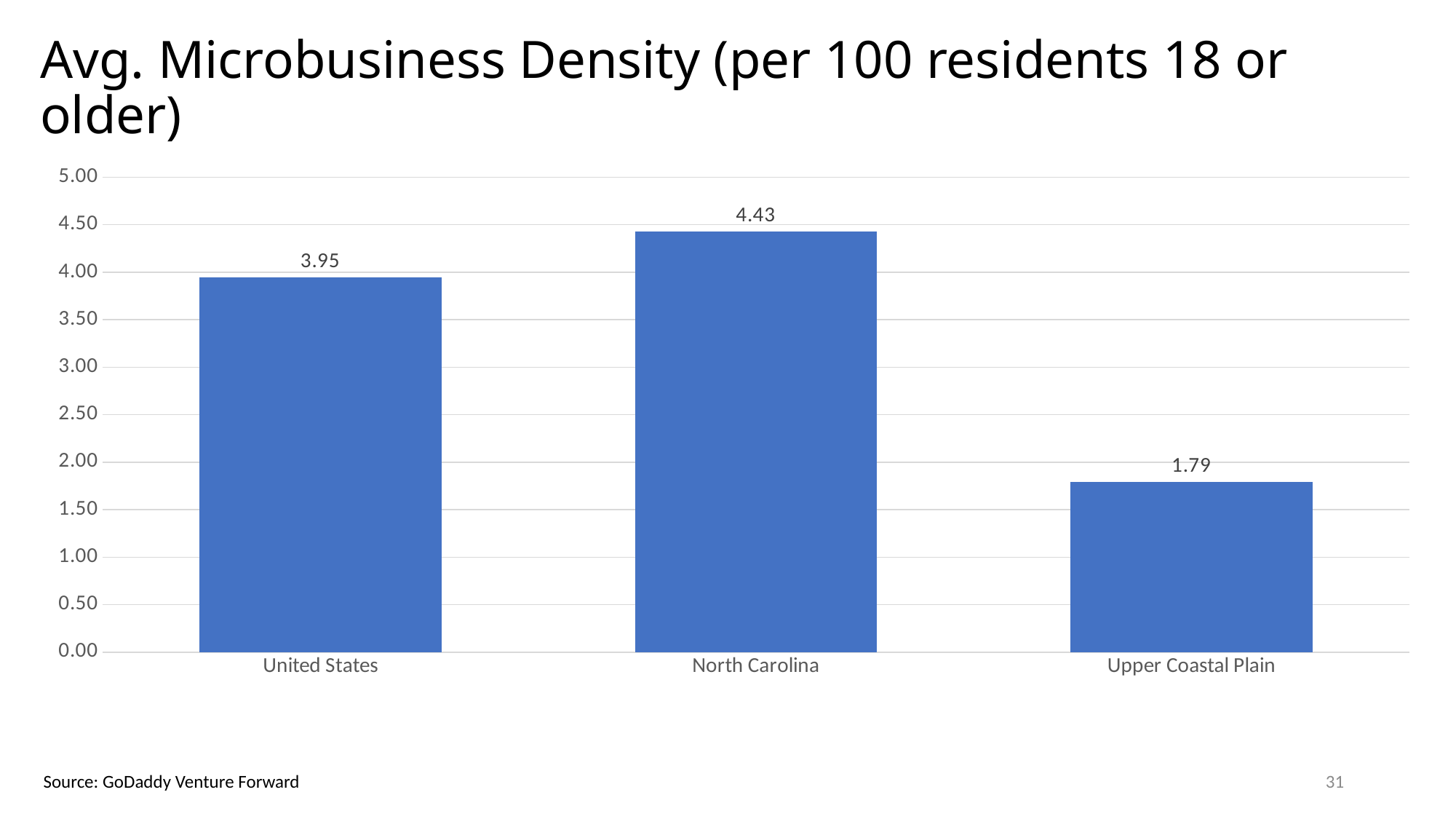
What is the average microbusiness density for the United States? 3.95 What is the difference between the North Carolina and United States values? 0.48 What kind of chart is shown on the slide? Bar chart What is the average microbusiness density for the Upper Coastal Plain? 1.79 Is the value for the Upper Coastal Plain greater or less than 2.00? less How many categories are shown in the chart? 3 What is the difference between the United States and Upper Coastal Plain values? 2.16 What is the average microbusiness density for North Carolina? 4.43 Which category has the lowest average microbusiness density? Upper Coastal Plain Which category has the highest average microbusiness density? North Carolina Which is larger, the value for the United States or the value for the Upper Coastal Plain? United States What is the source cited for the chart? GoDaddy Venture Forward